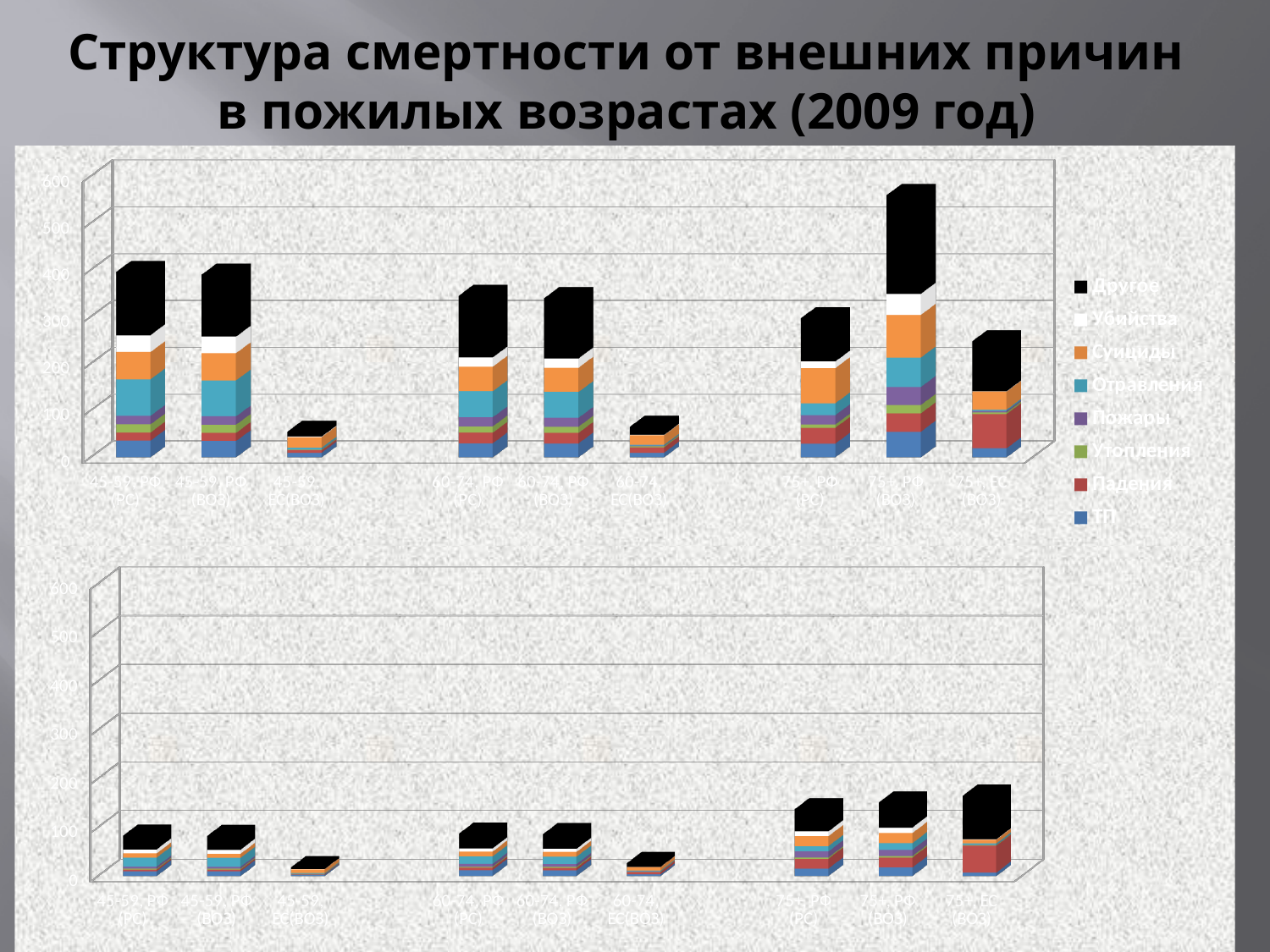
In the top chart, which category has the tallest stacked bar? 75+ РФ (ВОЗ) In the bottom chart, is the total for 75+ ЕС (ВОЗ) greater or less than 300? less In the top chart, is the total for 75+ РФ (ВОЗ) greater or less than 500? greater In the top chart, is the total for 45-59 ЕС(ВОЗ) greater or less than 100? less In the bottom chart, which bar is taller: 75+ ЕС (ВОЗ) or 45-59 ЕС(ВОЗ)? 75+ ЕС (ВОЗ) How many series does the legend list? 8 What kind of chart is the top chart on the slide? stacked bar chart In the top chart, which bar is taller: 75+ РФ (ВОЗ) or 45-59 РФ (РС)? 75+ РФ (ВОЗ) Which series is shown in black in the legend? Другое In the bottom chart, which category has the tallest stacked bar? 75+ ЕС (ВОЗ) How many categories are shown on the x axis of the top chart? 9